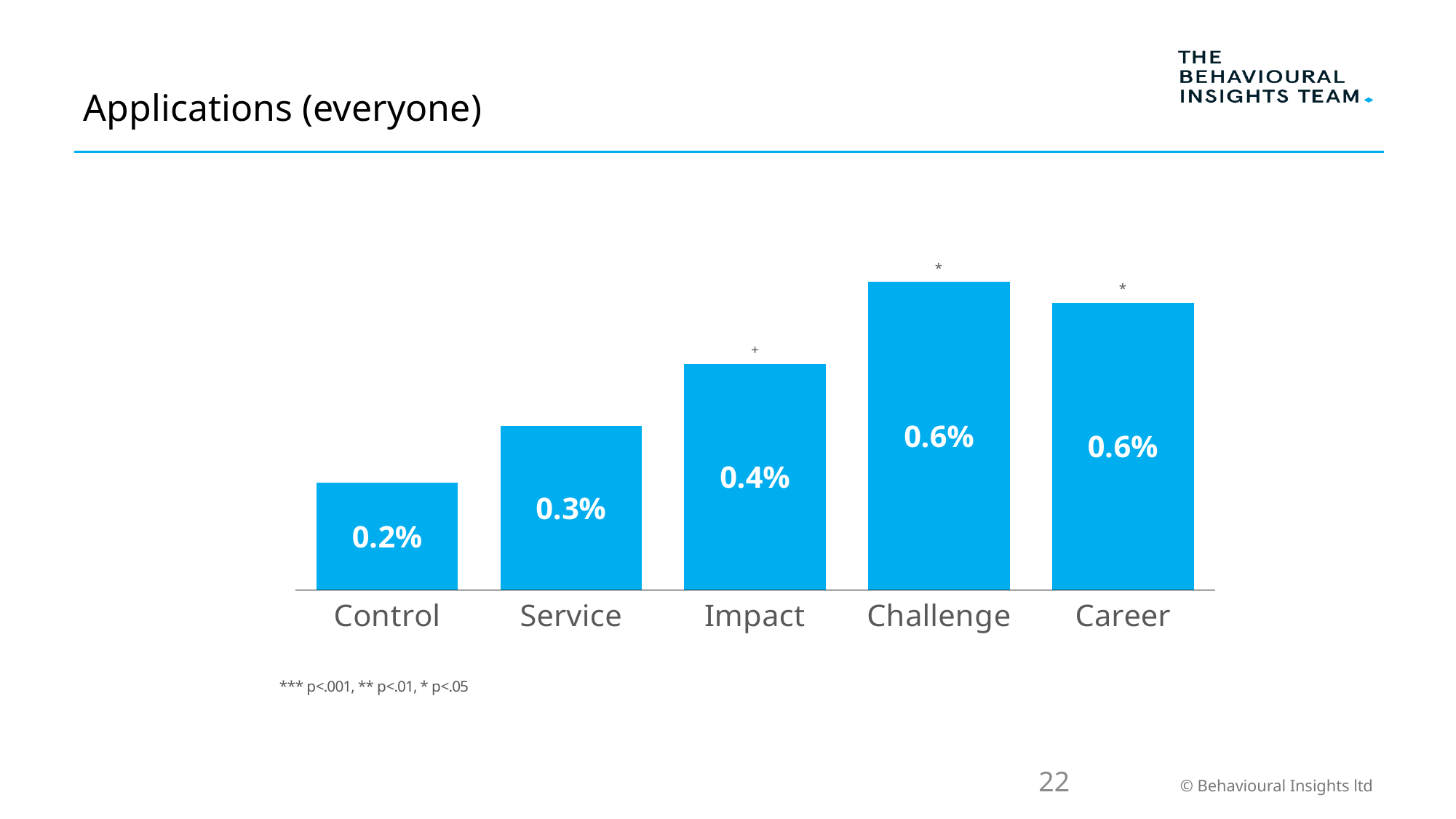
What is the value for Career? 0.6% Which is larger, the value for Impact or the value for Service? Impact How many categories are shown on the chart? 5 What is the difference between the values for Challenge and Control? 0.4 percentage points What is the value for Service? 0.3% Which category has the lowest value? Control Do the values generally rise or fall from Control to Challenge? Rise What is the value for Impact? 0.4% What is the difference between the values for Impact and Service? 0.1 percentage points What kind of chart is shown on the slide? Bar chart What is the value for Control? 0.2% What is the value for Challenge? 0.6%